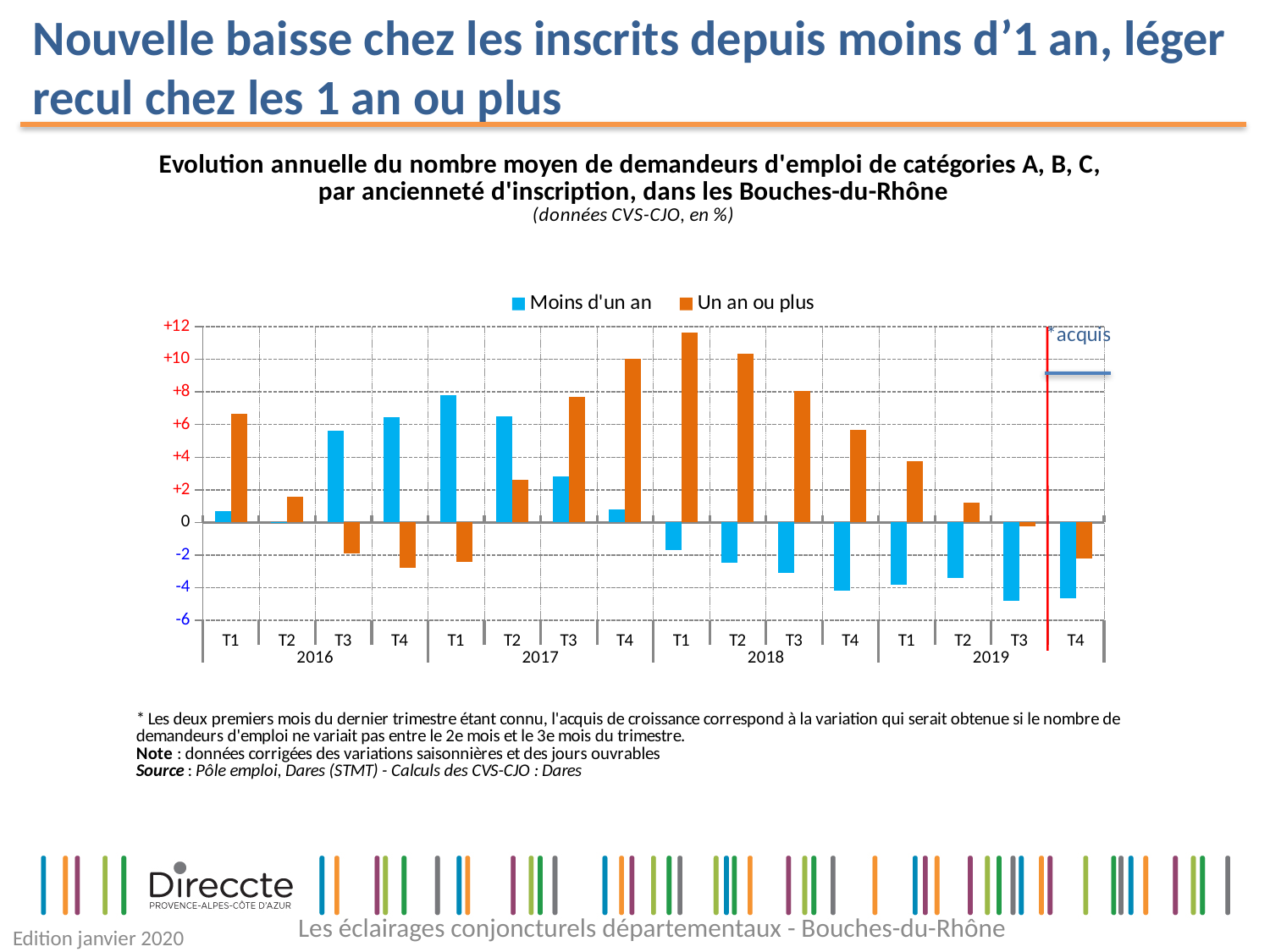
What are the two series named in the legend? Moins d'un an; Un an ou plus What kind of chart is shown on the slide? Bar chart In T3 2016, which series has the larger value, 'Moins d'un an' or 'Un an ou plus'? Moins d'un an How many quarters (T1–T4 bars groups) are shown along the x axis? 16 In which quarter does the 'Moins d'un an' series reach its highest value? T1 2017 Is the value for 'Moins d'un an' in T1 2017 greater or less than +6? greater How many series does the legend list? 2 Does the 'Un an ou plus' series rise or fall from T1 2018 to T4 2019? Fall Is the value for 'Moins d'un an' in T4 2018 greater or less than -2? less Is the value for 'Un an ou plus' in T1 2018 greater or less than +10? greater In T3 2017, which series has the larger value, 'Moins d'un an' or 'Un an ou plus'? Un an ou plus In which quarter does the 'Un an ou plus' series reach its highest value? T1 2018